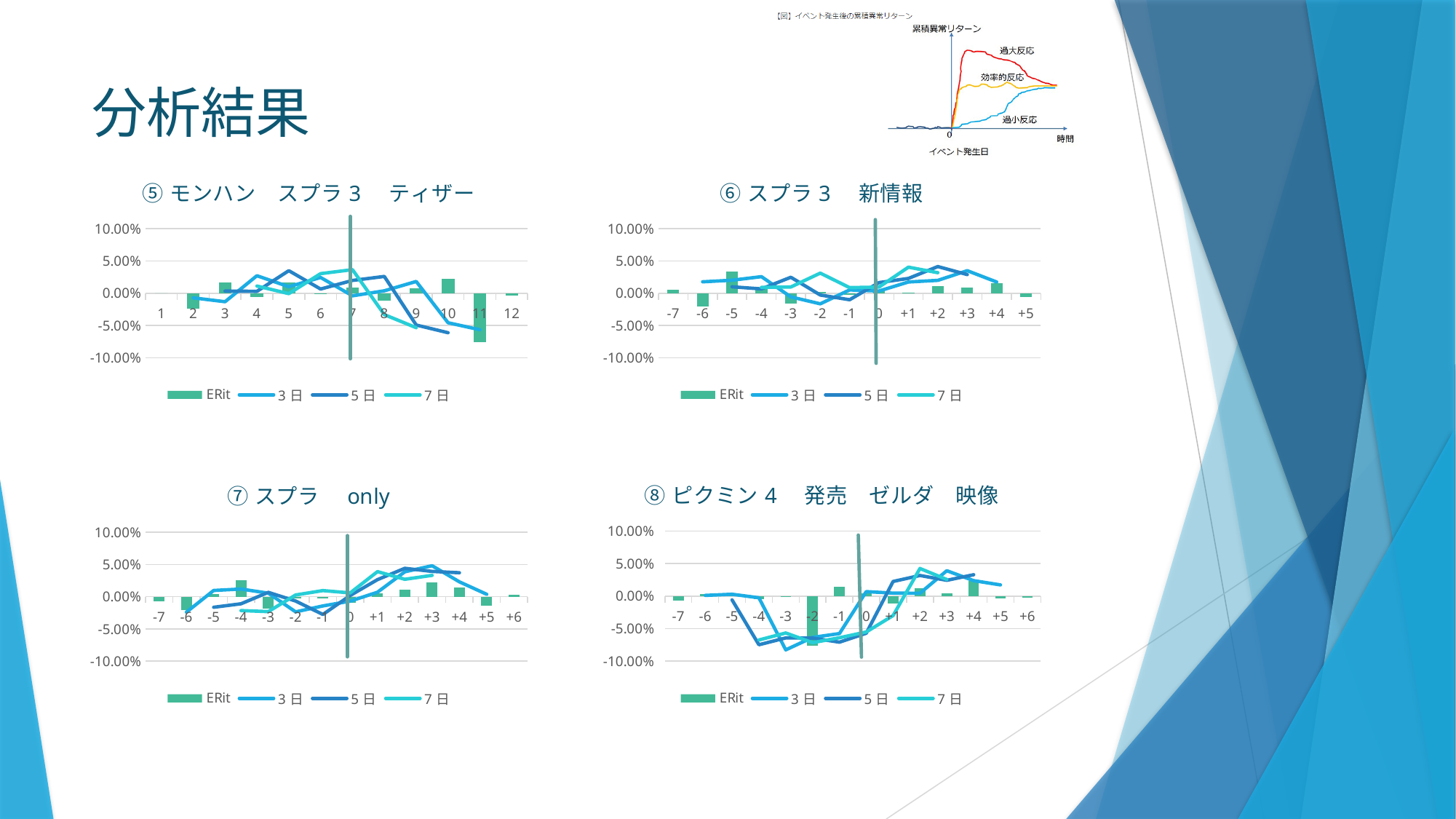
How many categories are on the x axis of the chart titled ⑤ モンハン スプラ 3 ティザー? 12 In the chart titled ⑥ スプラ 3 新情報, at which category is the ERit bar highest? -5 In the chart titled ⑤ モンハン スプラ 3 ティザー, which is larger, the ERit value at category 10 or at category 11? 10 How many categories are on the x axis of the chart titled ⑥ スプラ 3 新情報? 13 In the chart titled ⑤ モンハン スプラ 3 ティザー, at which category is the ERit bar lowest? 11 In the chart titled ⑧ ピクミン 4 発売 ゼルダ 映像, at which category is the ERit bar lowest? -2 How many series does the legend of the chart titled ⑤ モンハン スプラ 3 ティザー list? 4 In the chart titled ⑤ モンハン スプラ 3 ティザー, is the ERit value at category 11 greater or less than -5.00%? less In the chart titled ⑦ スプラ only, at which category is the ERit bar highest? -4 How many categories are on the x axis of the chart titled ⑦ スプラ only? 14 In the chart titled ⑧ ピクミン 4 発売 ゼルダ 映像, is the ERit value at category -2 greater or less than -5.00%? less What kind of chart is the chart titled ⑥ スプラ 3 新情報? Combination bar and line chart